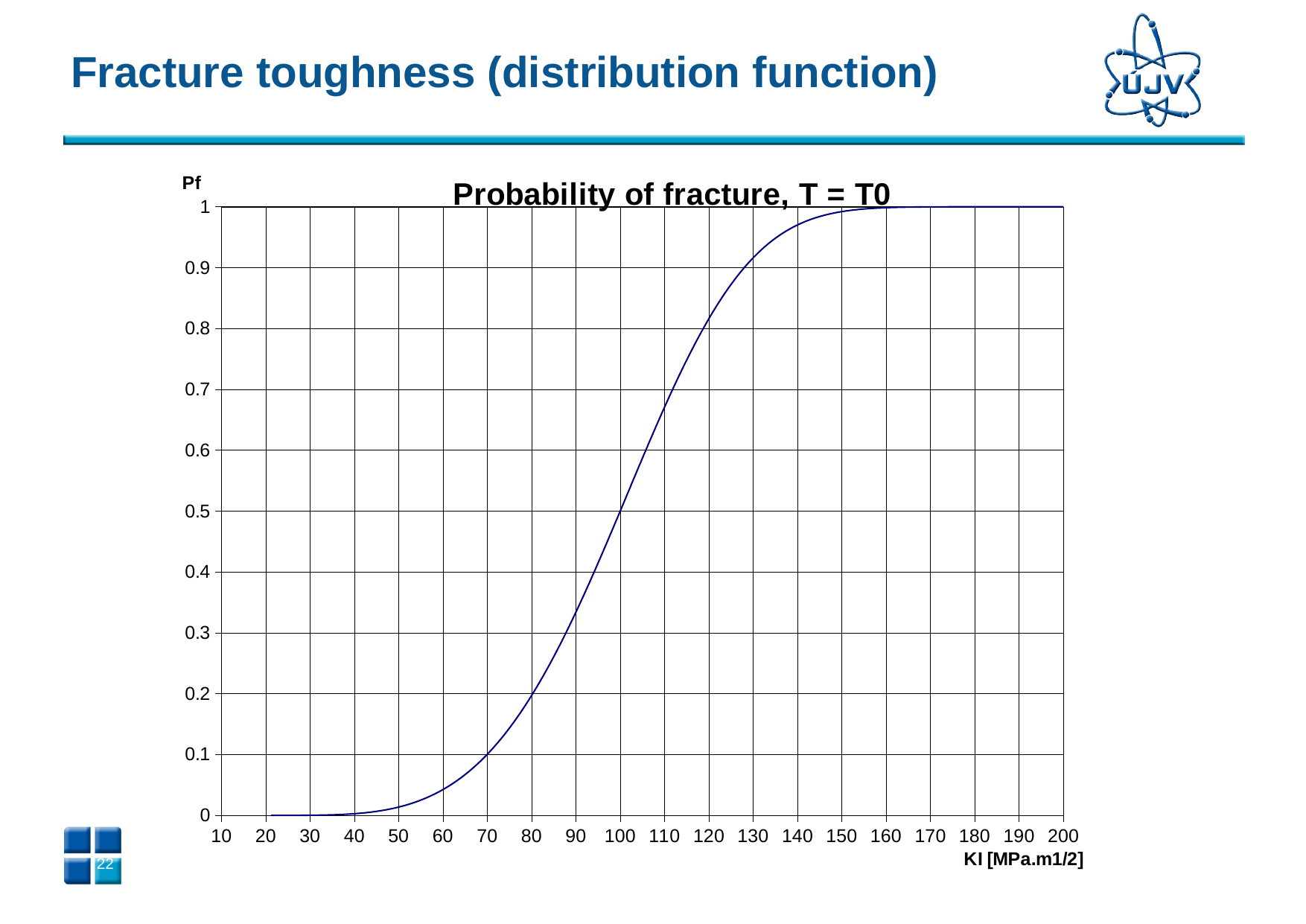
Is the value of Pf at KI = 90 greater or less than 0.4? less Is the value of Pf at KI = 130 greater or less than 0.8? greater What is the label of the x axis of the chart? KI [MPa.m1/2] Is the value of Pf at KI = 110 greater or less than 0.7? less How many curves are plotted on the chart? 1 Does the plotted probability of fracture rise or fall as KI increases along the x axis? rise What is the title of the chart? Probability of fracture, T = T0 What kind of chart is shown on the slide? line chart